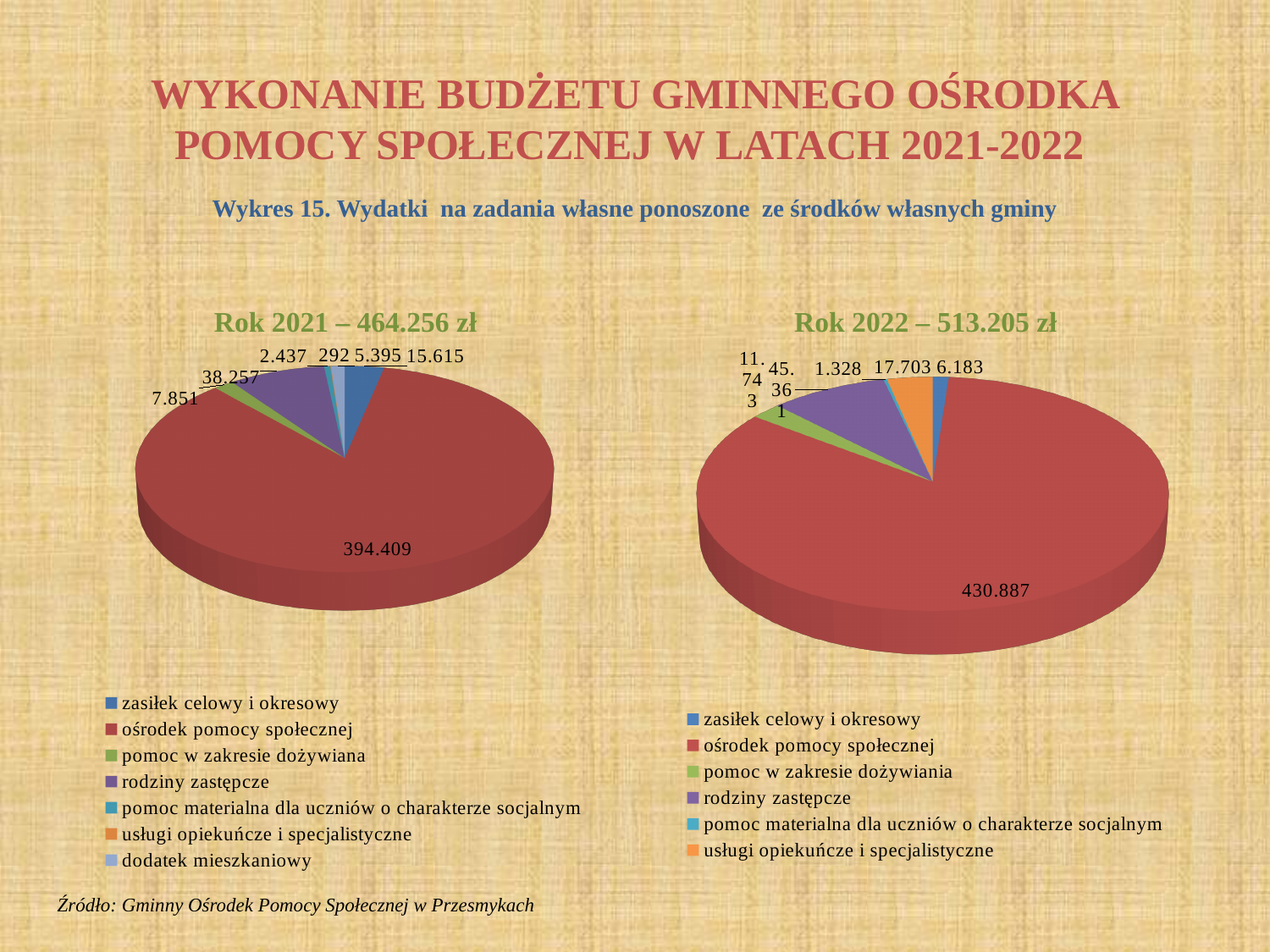
In the Rok 2021 pie chart, which category has the largest slice? ośrodek pomocy społecznej In the Rok 2022 pie chart, what is the value for usługi opiekuńcze i specjalistyczne? 17.703 What is the difference between the value for ośrodek pomocy społecznej in the Rok 2022 chart and in the Rok 2021 chart? 36.478 In the Rok 2022 pie chart, what is the value for ośrodek pomocy społecznej? 430.887 In the Rok 2021 pie chart, which category has the smallest value? usługi opiekuńcze i specjalistyczne How many categories does the legend of the Rok 2022 pie chart list? 6 What type of chart is used for Rok 2021 and Rok 2022? Pie chart In the Rok 2021 pie chart, what is the value for ośrodek pomocy społecznej? 394.409 In the Rok 2022 pie chart, which category has the smallest value? pomoc materialna dla uczniów o charakterze socjalnym In the Rok 2021 pie chart, what is the value for dodatek mieszkaniowy? 5.395 In the Rok 2021 pie chart, what is the value for rodziny zastępcze? 38.257 In the Rok 2021 pie chart, which is larger: zasiłek celowy i okresowy or pomoc w zakresie dożywiana? zasiłek celowy i okresowy